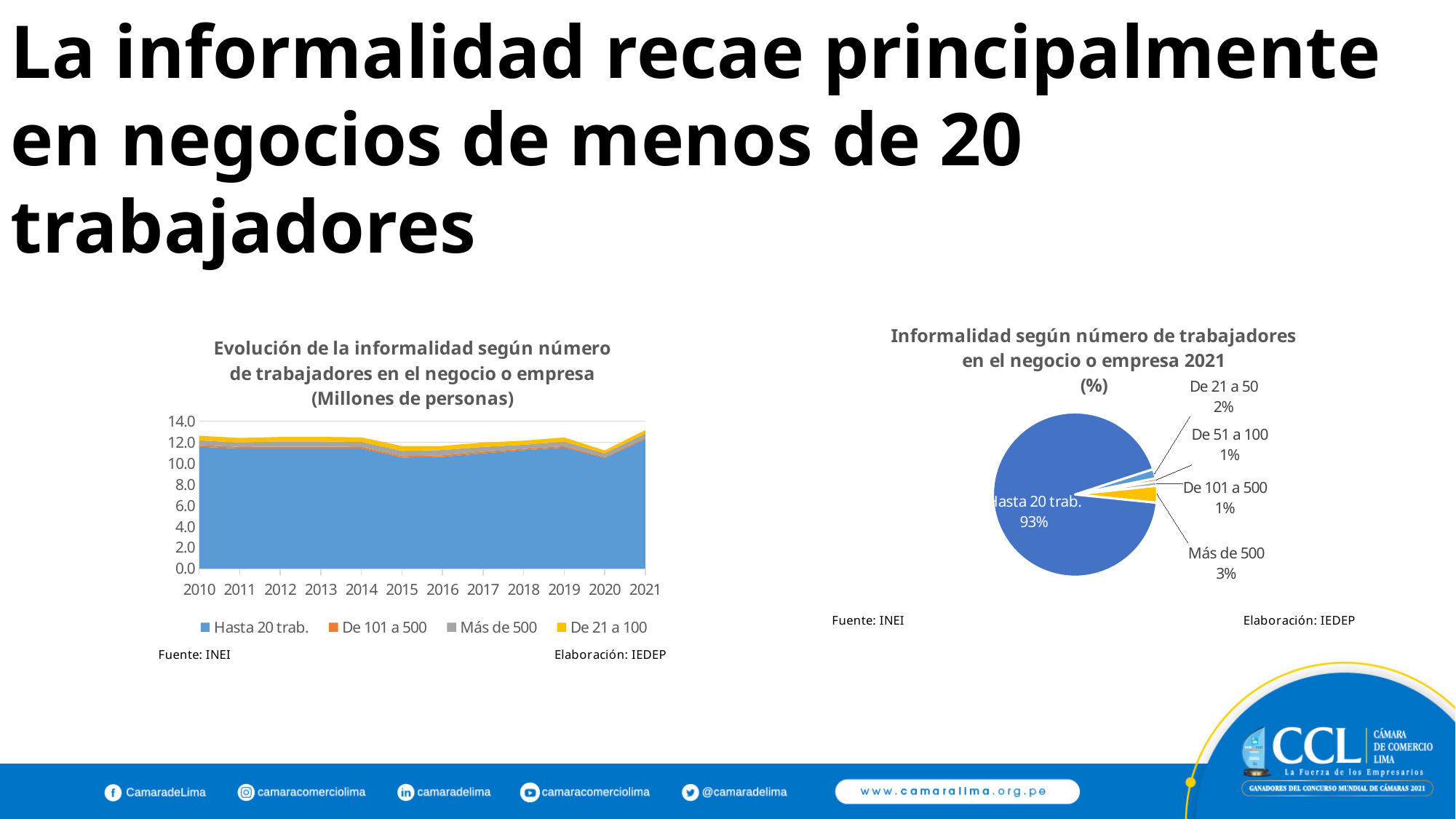
In the chart on the left, how many years are shown on the x axis? 12 In the pie chart on the right, which category has the largest slice? Hasta 20 trab. In the chart on the left, is the total stacked value for 2021 greater or less than 12.0? greater In the chart on the left, is the total stacked value for 2020 greater or less than 12.0? less In the pie chart on the right, what is the difference in percentage points between 'Hasta 20 trab.' and 'Más de 500'? 90 percentage points In the pie chart on the right, what percentage is shown for 'De 21 a 50'? 2% In the chart on the left, how many series does the legend list? 4 What kind of chart is the chart on the right? Pie chart In the pie chart on the right, what percentage is shown for 'Más de 500'? 3% In the pie chart on the right, which is larger: 'Más de 500' or 'De 51 a 100'? Más de 500 In the pie chart on the right, what share of informality corresponds to 'Hasta 20 trab.'? 93% In the pie chart on the right, how many slices (categories) are there? 5